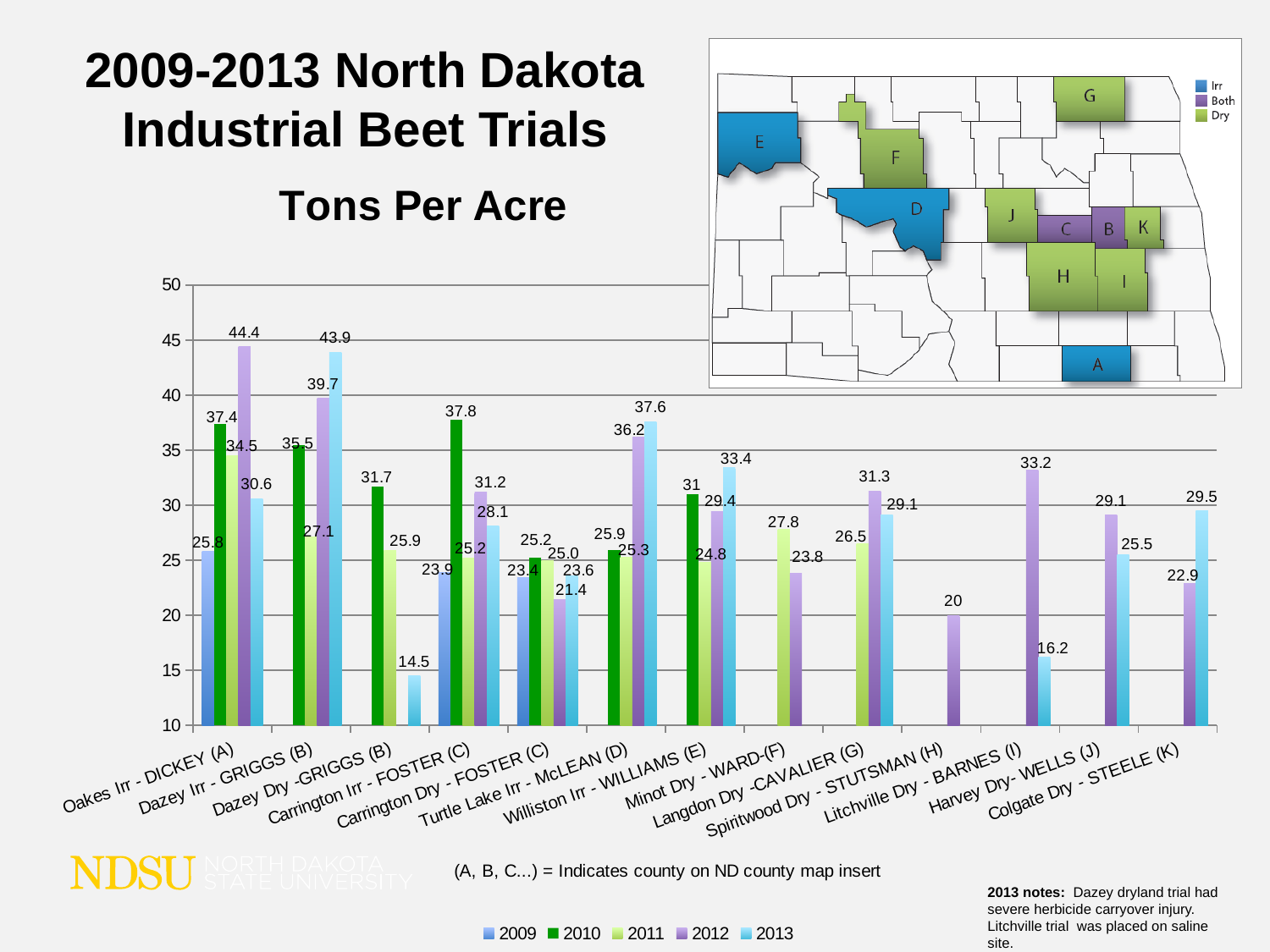
How many series does the legend list? 5 How many trial locations (categories) are shown on the x axis? 13 Is the 2013 value for Dazey Irr - GRIGGS (B) greater or less than 40? greater What was the 2013 tons per acre value for Dazey Dry - GRIGGS (B)? 14.5 What is the unit of measurement shown in the chart subtitle? Tons Per Acre What is the difference between the 2013 and 2012 values for Turtle Lake Irr - McLEAN (D)? 1.4 Which location and year has the highest tons per acre on the chart? Oakes Irr - DICKEY (A), 2012 Which location and year has the lowest tons per acre on the chart? Dazey Dry - GRIGGS (B), 2013 What was the 2012 tons per acre value for Oakes Irr - DICKEY (A)? 44.4 Which is larger for Litchville Dry - BARNES (I): the 2012 value or the 2013 value? 2012 What was the 2012 value for Spiritwood Dry - STUTSMAN (H)? 20 What kind of chart is shown on the slide? bar chart